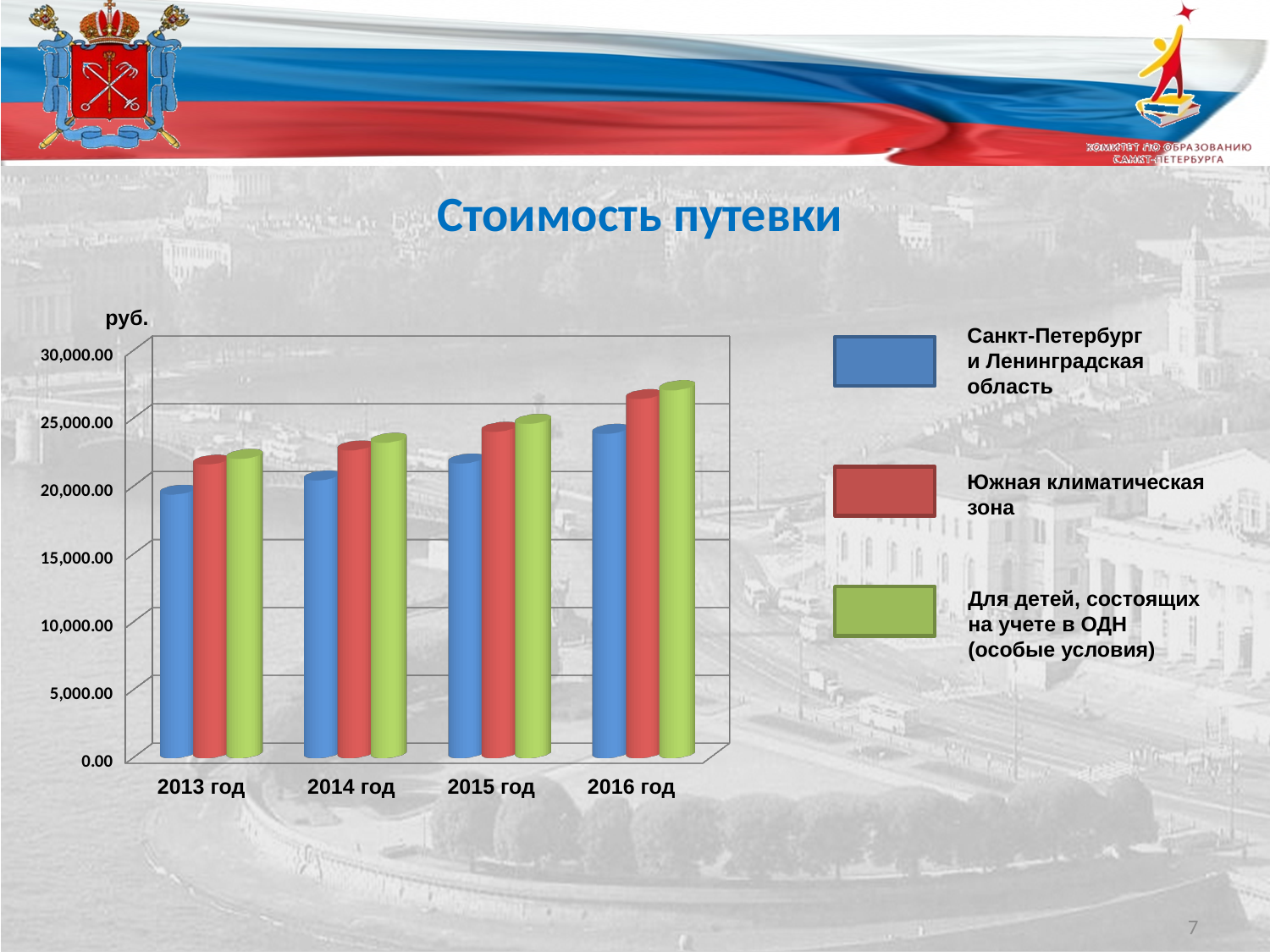
How many year categories are shown on the x axis? 4 How many series does the legend list? 3 Is the value for Санкт-Петербург и Ленинградская область in 2015 год greater or less than 20,000.00? greater Do the values for Южная климатическая зона rise or fall from 2013 год to 2016 год? rise What kind of chart is shown on the slide? bar chart Which series is shown in green in the legend? Для детей, состоящих на учете в ОДН (особые условия) Is the value for Южная климатическая зона in 2013 год greater or less than 20,000.00? greater Which year has the lowest value for Санкт-Петербург и Ленинградская область? 2013 год In which year is the value for Санкт-Петербург и Ленинградская область the highest? 2016 год Is the value for Санкт-Петербург и Ленинградская область in 2016 год greater or less than 25,000.00? less What is the title of the chart? Стоимость путевки